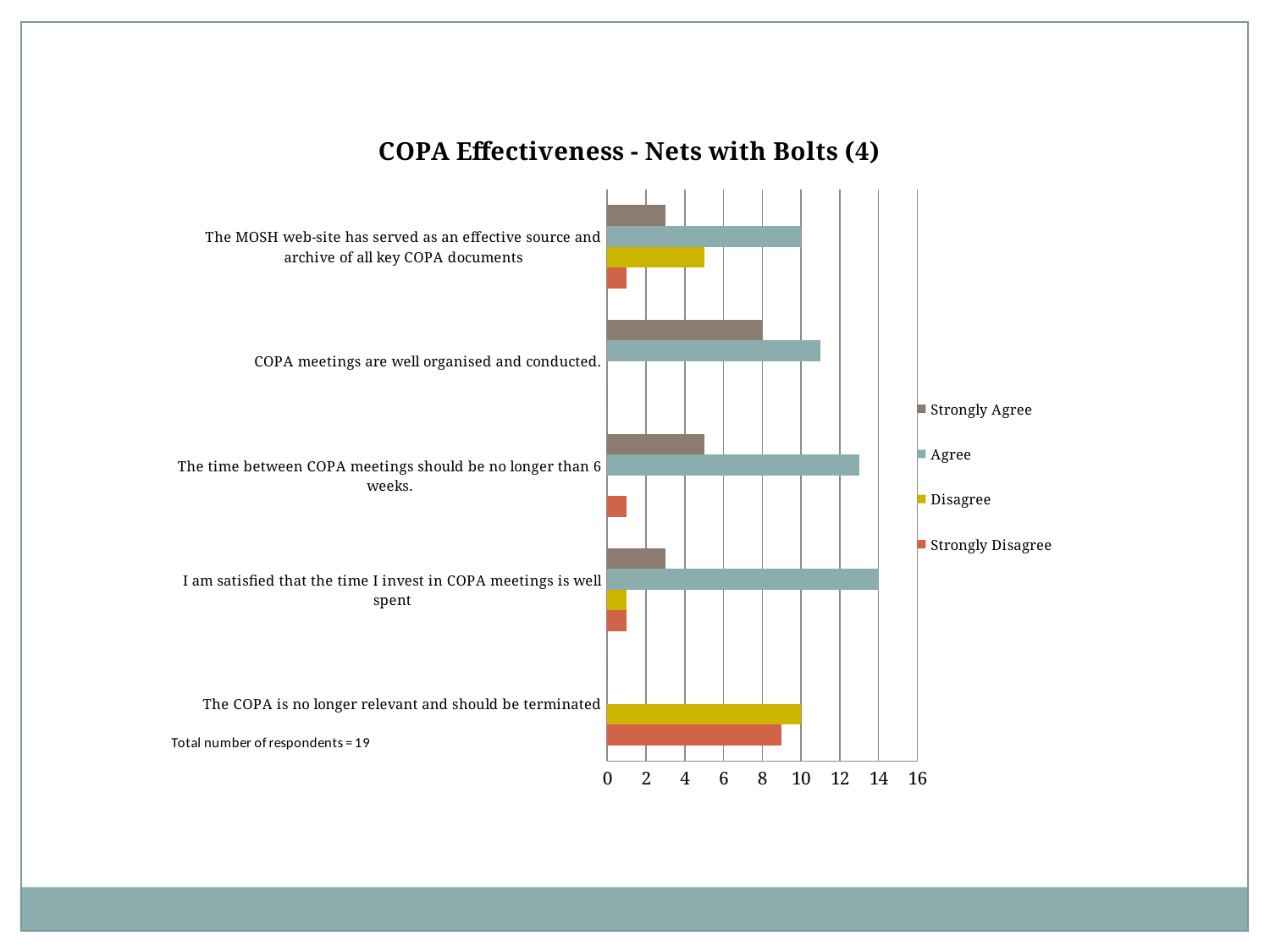
Which statement has the highest Agree value? I am satisfied that the time I invest in COPA meetings is well spent What is the Agree value for 'I am satisfied that the time I invest in COPA meetings is well spent'? 14 What is the Strongly Agree value for 'COPA meetings are well organised and conducted.'? 8 What kind of chart is shown on the slide? Bar chart How many series does the legend list? 4 What is the Disagree value for 'The COPA is no longer relevant and should be terminated'? 10 What is the title of the chart? COPA Effectiveness - Nets with Bolts (4) What is the Agree value for 'The MOSH web-site has served as an effective source and archive of all key COPA documents'? 10 Is the Agree value for 'The time between COPA meetings should be no longer than 6 weeks.' greater or less than 12? greater How many statements (categories) are shown on the chart? 5 Which is larger for 'The MOSH web-site has served as an effective source and archive of all key COPA documents': the Disagree value or the Strongly Agree value? Disagree Is the Strongly Disagree value for 'The COPA is no longer relevant and should be terminated' greater or less than 8? greater